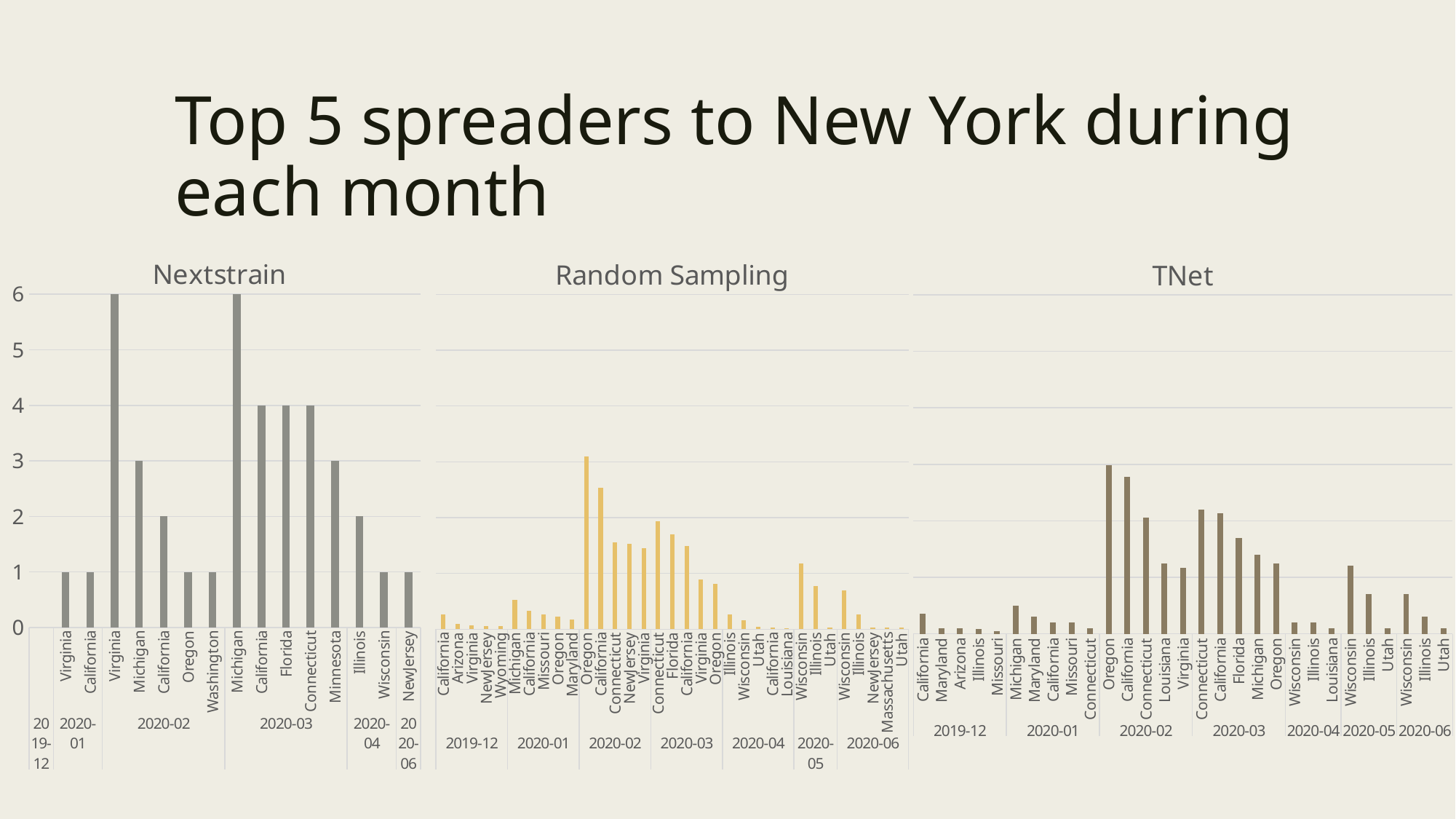
In the Nextstrain chart, what is the value for Illinois in 2020-04? 2 How many charts are shown on the slide? 3 In the Nextstrain chart, what is the value for Virginia in 2020-02? 6 In the Nextstrain chart, what is the value for Minnesota in 2020-03? 3 In the Nextstrain chart, which is larger in 2020-03: Florida or Minnesota? Florida In the TNet chart, is the value for Florida in 2020-03 greater or less than 1? greater What kind of chart is the Nextstrain chart? bar chart How many bars are plotted in the Nextstrain chart? 15 In the Random Sampling chart, which state in which month has the highest bar? Oregon, 2020-02 In the Nextstrain chart, what is the difference between Michigan and California in 2020-02? 1 In the Random Sampling chart, is the value for Oregon in 2020-02 greater or less than 3? greater